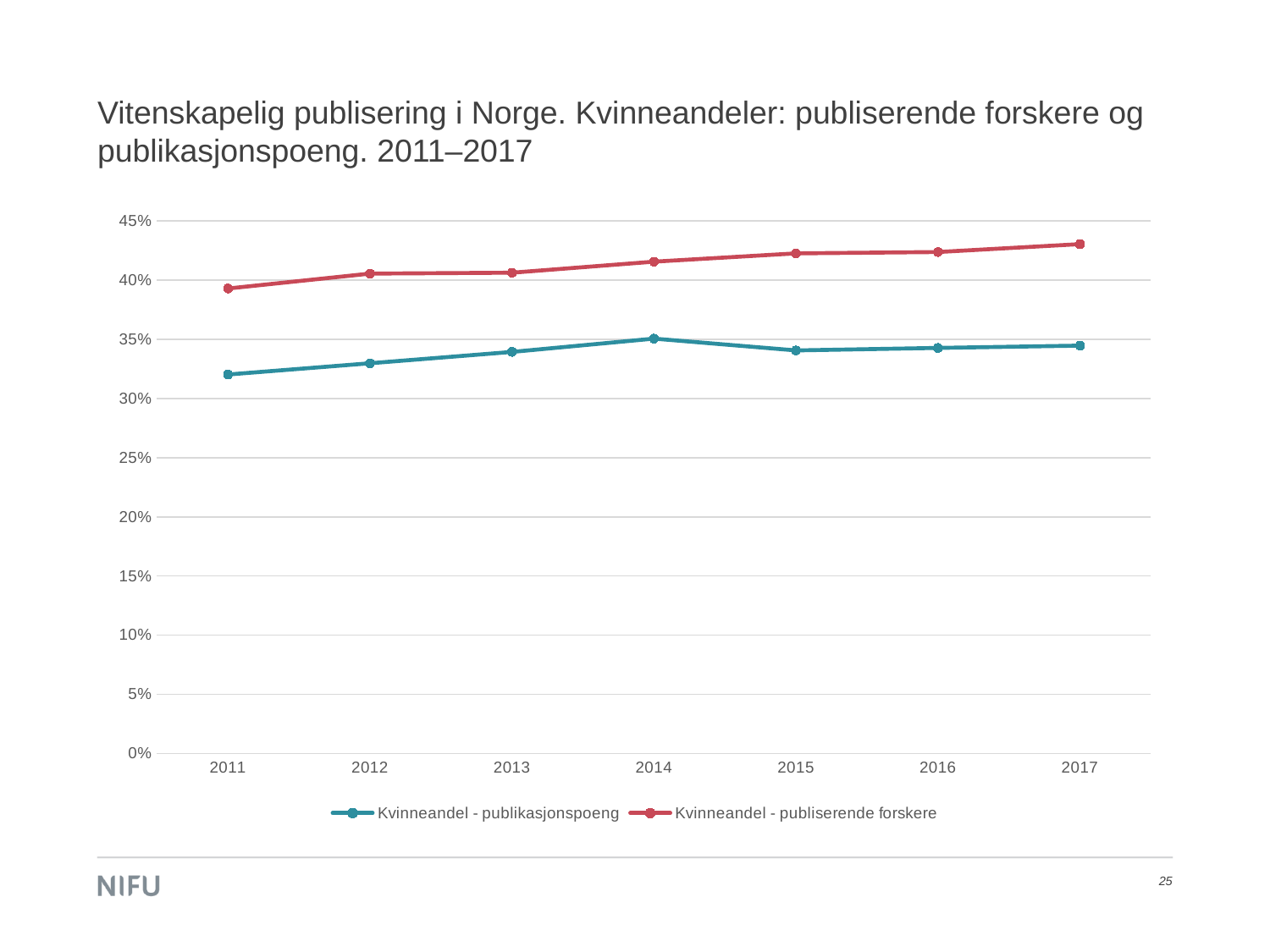
What kind of chart is shown on the slide? line chart How many years are plotted along the x axis? 7 Is the value for Kvinneandel - publikasjonspoeng in 2011 greater or less than 30%? greater Does the Kvinneandel - publiserende forskere line rise or fall from 2011 to 2017? rise Is the value for Kvinneandel - publiserende forskere in 2011 greater or less than 40%? less In which year is Kvinneandel - publikasjonspoeng at its lowest? 2011 How many series does the legend list? 2 In which year is Kvinneandel - publiserende forskere at its highest? 2017 In 2014, which series has the higher value: Kvinneandel - publikasjonspoeng or Kvinneandel - publiserende forskere? Kvinneandel - publiserende forskere Which series is drawn in red? Kvinneandel - publiserende forskere Is the value for Kvinneandel - publikasjonspoeng in 2017 greater or less than 40%? less